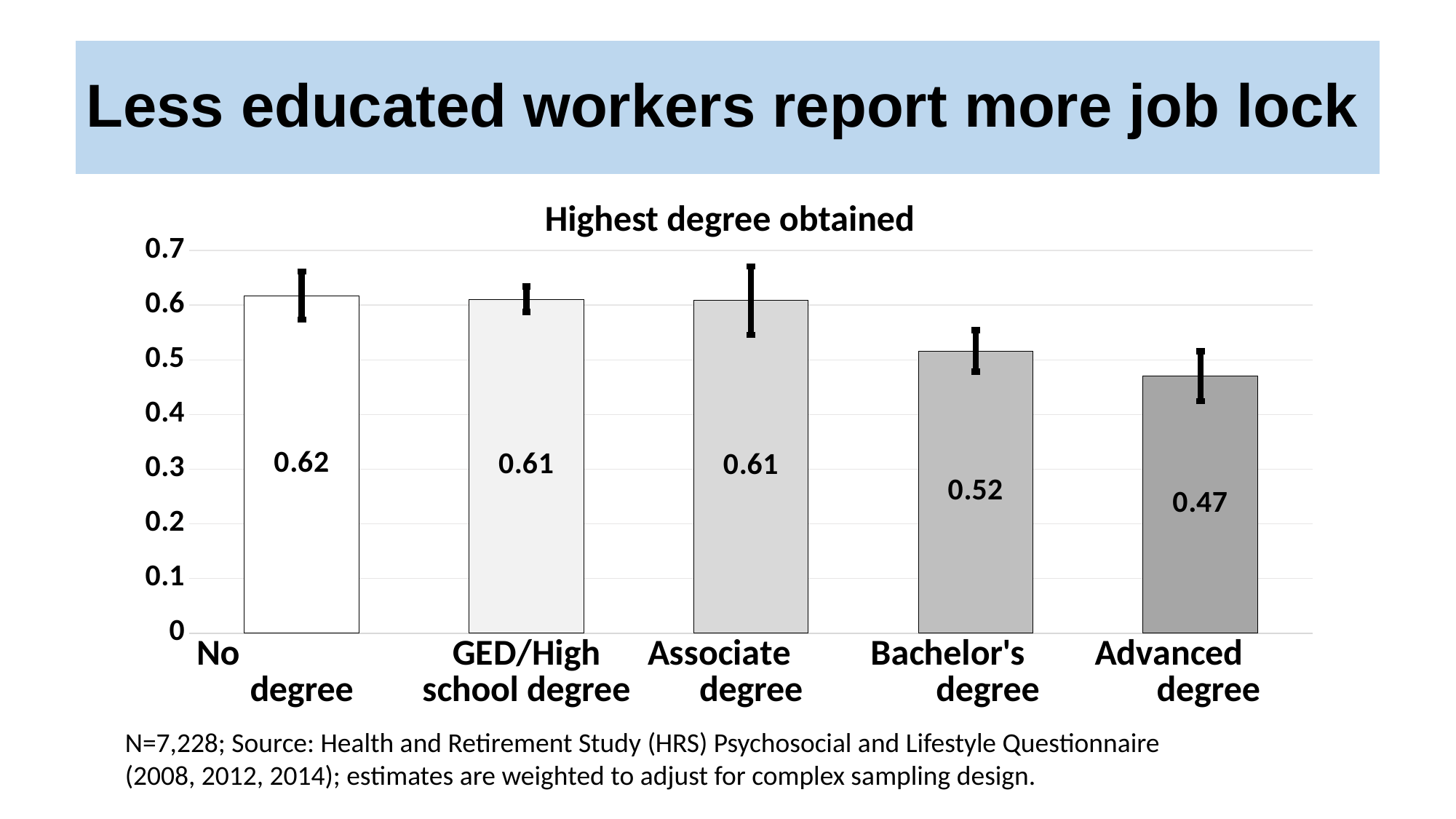
What is the title of the chart? Highest degree obtained What is the value for Advanced degree? 0.47 Which category has the highest value? No degree What is the value for Associate degree? 0.61 What kind of chart is shown on the slide? Bar chart Which category has the lowest value? Advanced degree What is the value for Bachelor's degree? 0.52 What is the difference between the values for No degree and Advanced degree? 0.15 Which is larger, the value for GED/High school degree or the value for Bachelor's degree? GED/High school degree How many categories are shown on the x axis? 5 What is the value for No degree? 0.62 What is the difference between the values for Bachelor's degree and Advanced degree? 0.05